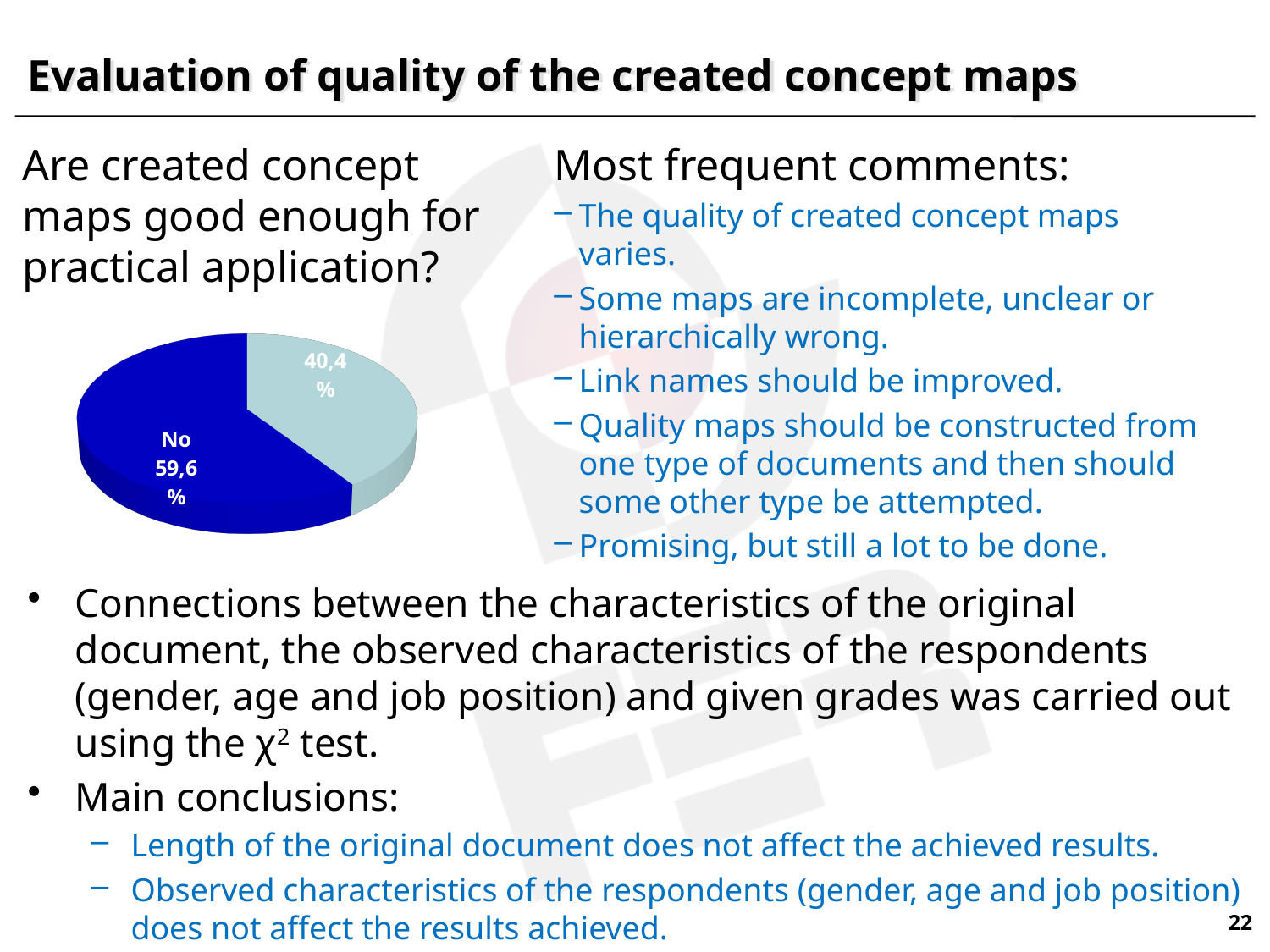
What question does the pie chart answer, according to the text above it? Are created concept maps good enough for practical application? What percentage is shown for the light blue slice of the pie chart? 40,4 % Is the "No" slice larger or smaller than the light blue slice in the pie chart? larger Which slice of the pie chart is the largest? No What is the difference in percentage points between the "No" slice and the light blue slice? 19,2 % How many slices does the pie chart have? 2 What percentage is shown for the "No" slice of the pie chart? 59,6 % What share of the pie does the "No" slice represent? 59,6 % What kind of chart is shown on the slide? pie chart What colour is the "No" slice in the pie chart? dark blue